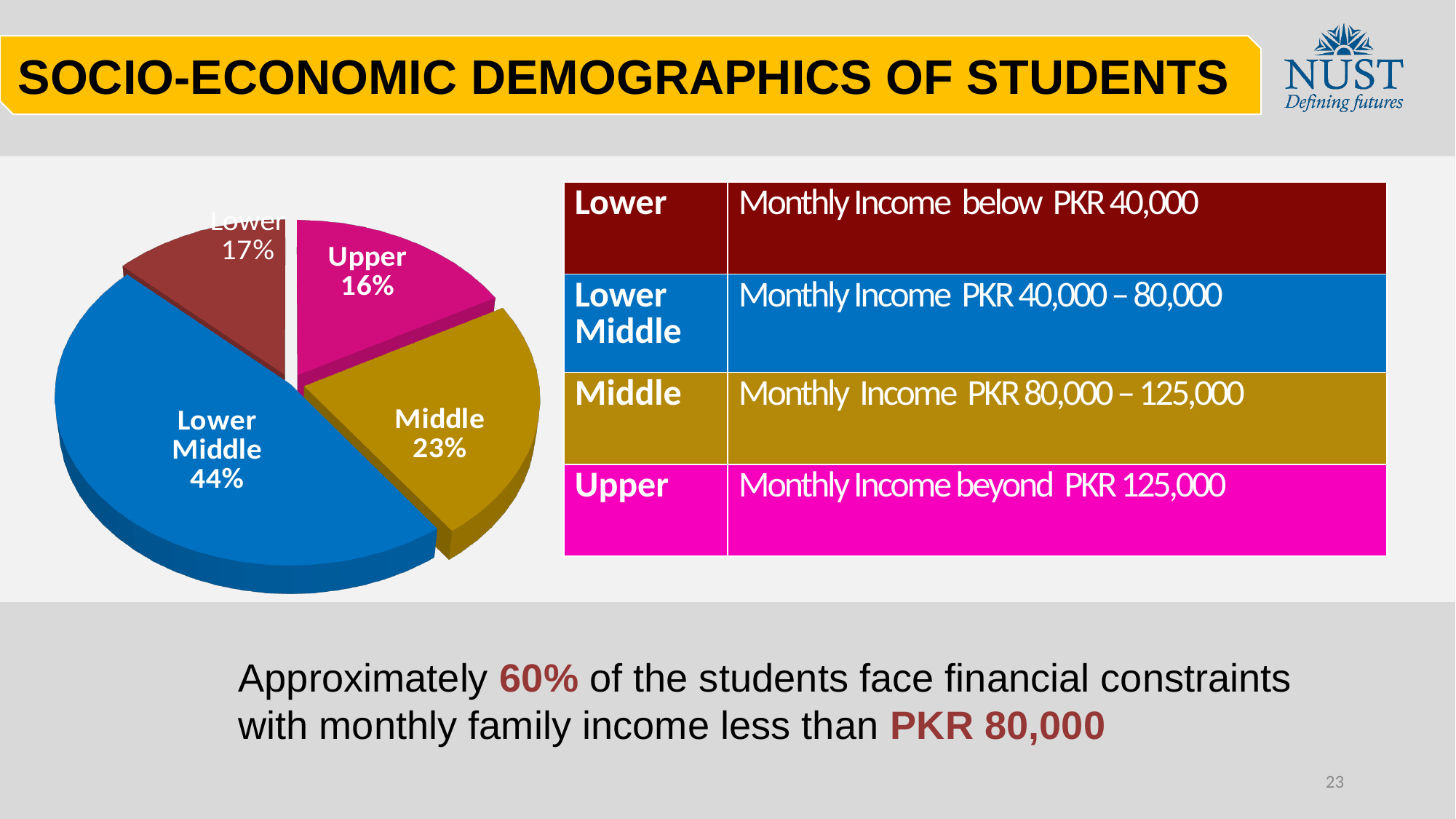
Which category has the largest share of students? Lower Middle How many categories does the pie chart show? 4 Which category has the smallest share of students? Upper What percentage of students are in the Lower category? 17% What kind of chart is shown on the slide? Pie chart Which is larger, the share for Middle or the share for Upper? Middle What is the combined share of the Lower and Lower Middle categories? 61% What is the difference in percentage points between the Lower Middle and Middle categories? 21 What share of students falls in the Lower Middle category? 44% What percentage of students are in the Middle category? 23% What percentage of students are in the Upper category? 16% What colour is the Lower Middle slice of the pie chart? Blue